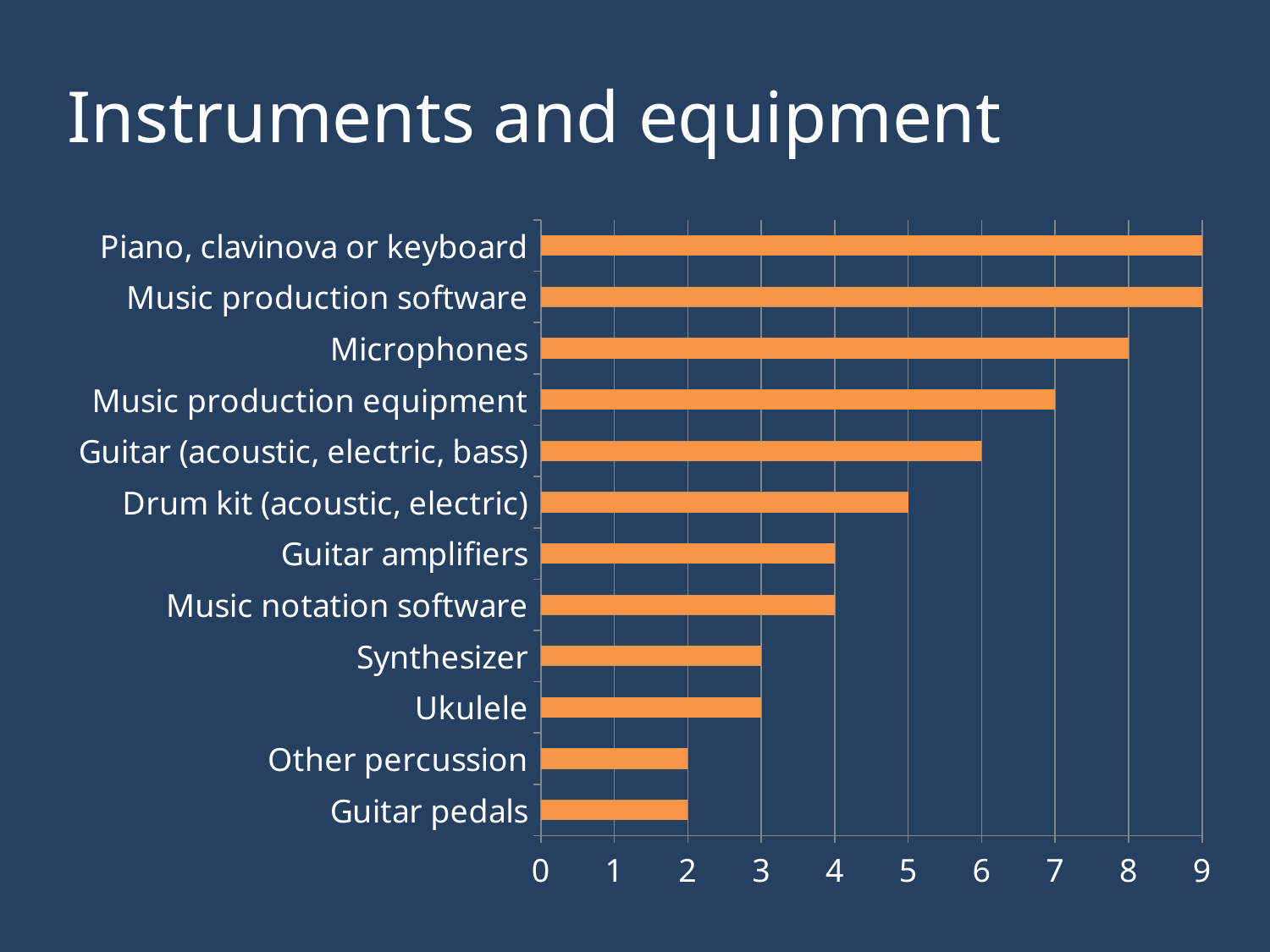
What is the value for Guitar (acoustic, electric, bass)? 6 Which has a larger value, Music production equipment or Drum kit (acoustic, electric)? Music production equipment What is the value for Synthesizer? 3 What is the value for Microphones? 8 What is the difference between the values for Microphones and Guitar amplifiers? 4 What kind of chart is shown on the slide? bar chart What is the title of the slide? Instruments and equipment Is the value for Guitar (acoustic, electric, bass) greater or less than 5? greater What is the value for Music production equipment? 7 What is the difference between the values for Piano, clavinova or keyboard and Guitar pedals? 7 What is the value for Drum kit (acoustic, electric)? 5 How many categories are shown in the chart? 12